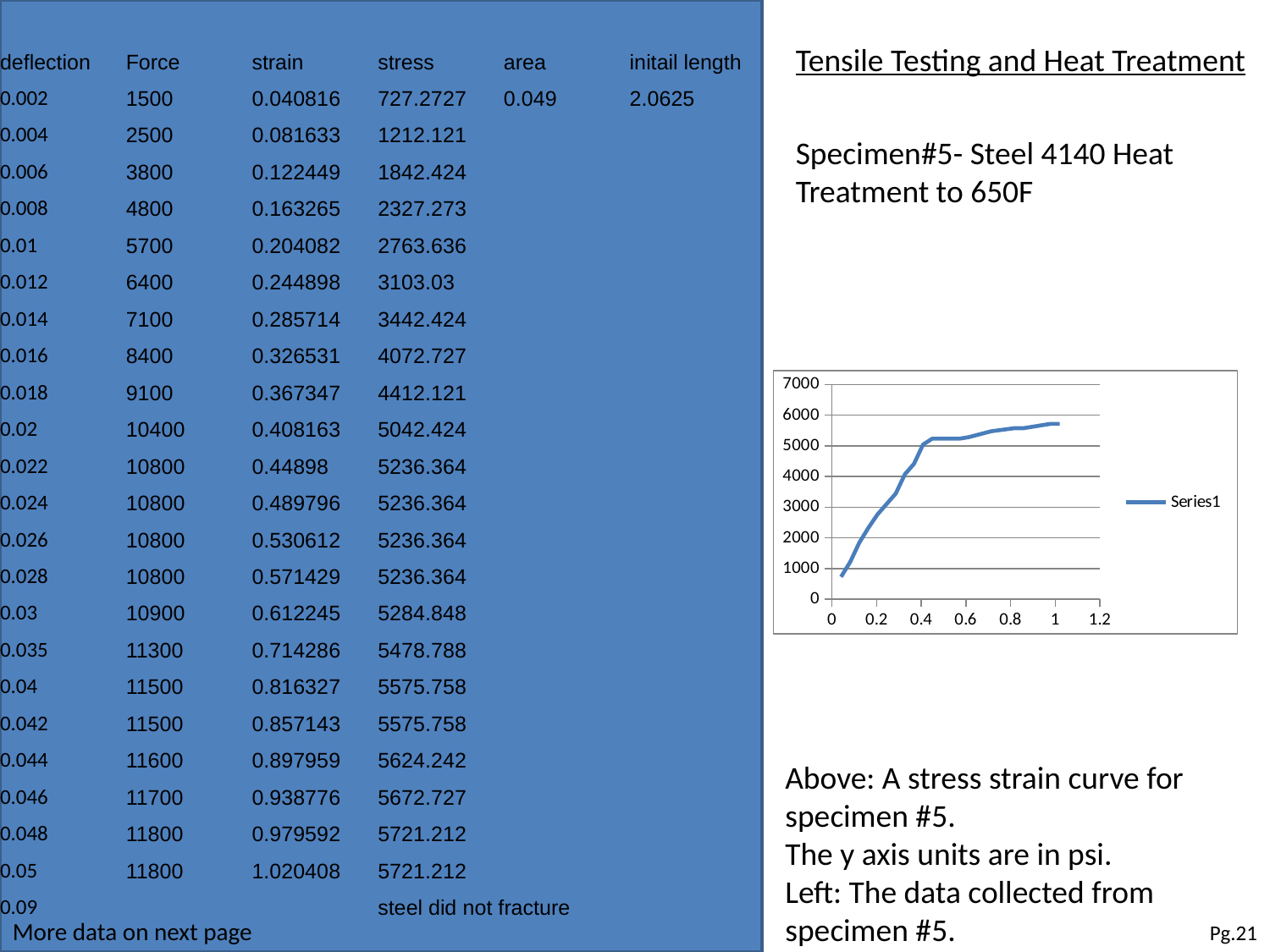
Is the value of Series1 at x = 1 greater or less than 6000? less What is the name of the series shown in the chart's legend? Series1 What is the highest tick value shown on the chart's y axis? 7000 How many series does the chart's legend list? 1 Is the value of Series1 at x = 0.2 larger or smaller than its value at x = 0.8? smaller Is the value of Series1 at x = 0.2 greater or less than 4000? less Is the value of Series1 at x = 0.8 greater or less than 5000? greater What kind of chart is shown on the slide? line chart Do the values in the chart rise or fall as you move along the x axis? rise